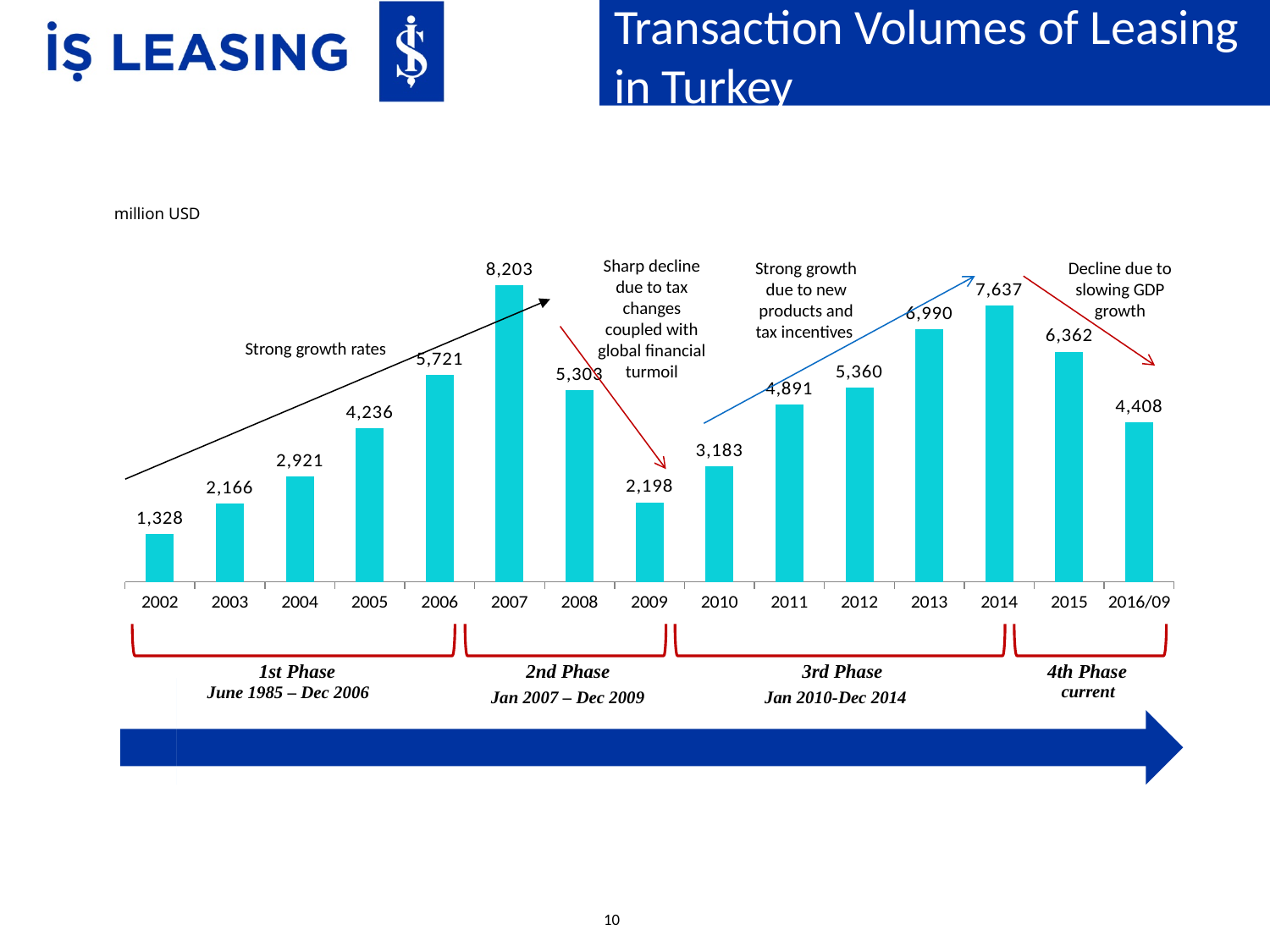
Which year had a larger transaction volume, 2008 or 2012? 2012 What is the title of the chart on this slide? Transaction Volumes of Leasing in Turkey What value is shown for 2016/09? 4,408 How many years (categories) are shown on the x axis? 15 Do the transaction volumes rise or fall from 2010 to 2014? Rise What was the leasing transaction volume in Turkey in 2007? 8,203 What unit are the transaction volumes expressed in? million USD What type of chart is used on this slide? Bar chart Which year has the lowest transaction volume? 2002 Which year has the highest transaction volume? 2007 What is the difference between the 2014 and 2015 transaction volumes? 1,275 What was the leasing transaction volume in 2009? 2,198